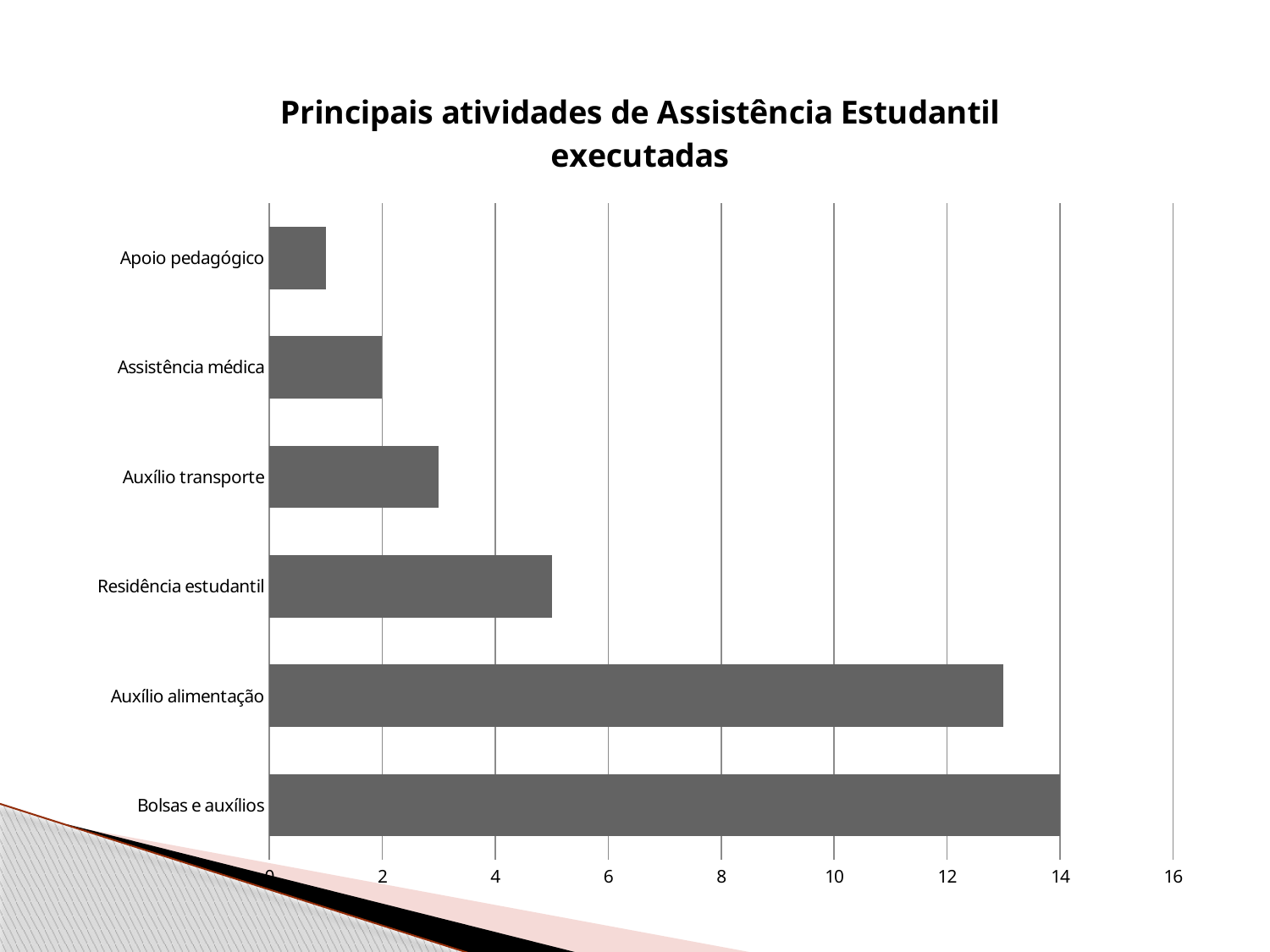
What is the title of the chart? Principais atividades de Assistência Estudantil executadas What is the difference between the values for Bolsas e auxílios and Assistência médica? 12 Which is larger, the value for Auxílio transporte or the value for Residência estudantil? Residência estudantil What is the value for Bolsas e auxílios? 14 What is the value for Assistência médica? 2 Which category has the highest value? Bolsas e auxílios Is the value for Apoio pedagógico greater or less than 2? less Is the value for Residência estudantil greater or less than 4? greater Which category has the lowest value? Apoio pedagógico What type of chart is shown on the slide? bar chart Is the value for Auxílio alimentação greater or less than 12? greater How many categories are shown in the chart? 6